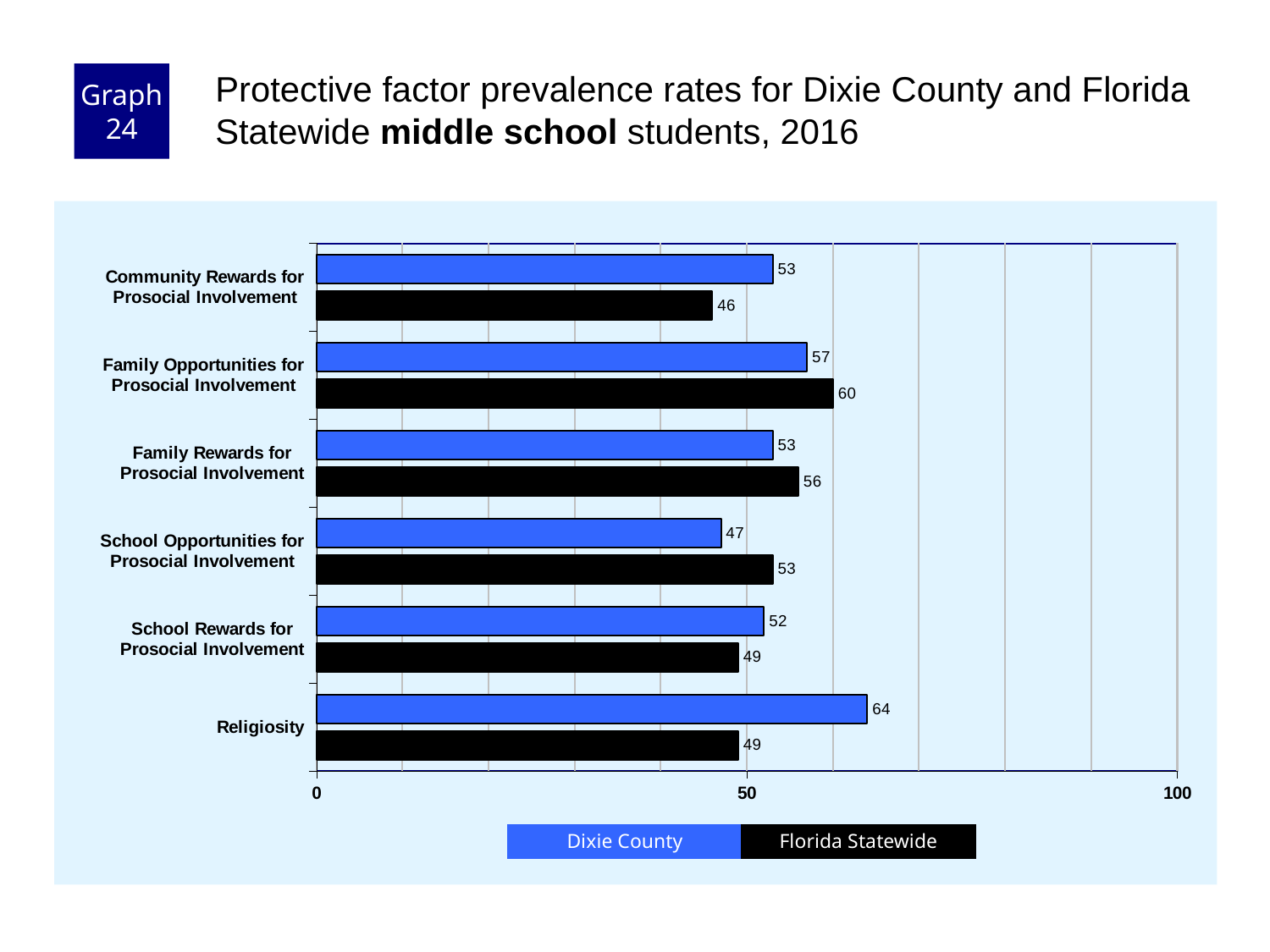
Which colour represents Florida Statewide in the chart? Black Which is larger for School Opportunities for Prosocial Involvement: Dixie County or Florida Statewide? Florida Statewide What is the Florida Statewide value for Family Opportunities for Prosocial Involvement? 60 What is the difference between the Dixie County and Florida Statewide values for Religiosity? 15 Which category has the highest Dixie County value? Religiosity What is the Florida Statewide value for Community Rewards for Prosocial Involvement? 46 How many series does the legend list? 2 What is the Dixie County value for Religiosity? 64 Which category has the lowest Florida Statewide value? Community Rewards for Prosocial Involvement Is the Dixie County value for Family Opportunities for Prosocial Involvement greater or less than 50? greater What kind of chart is shown on the slide? Bar chart How many categories are shown on the chart? 6